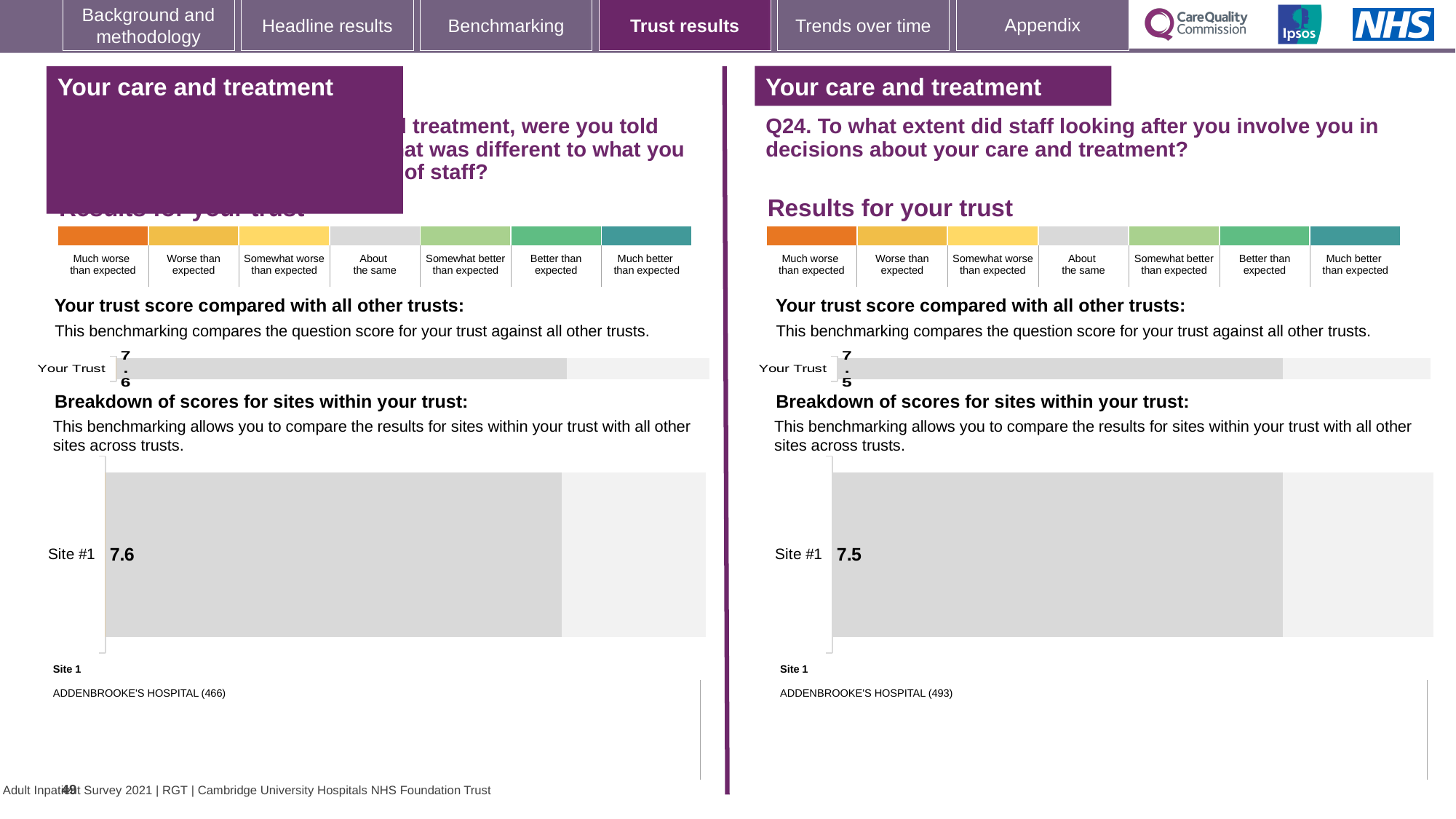
On the right-hand Q24 'Your trust score compared with all other trusts' chart, what is the score for Your Trust? 7.5 What kind of chart is used for the 'Your Trust' score on the right-hand Q24 section? Bar chart Which is larger: the Your Trust score on the left-hand chart or the Your Trust score on the right-hand Q24 chart? The left-hand chart (7.6) How many sites are shown in the right-hand Q24 'Breakdown of scores for sites within your trust' chart? 1 How many sites are shown in the left-hand 'Breakdown of scores for sites within your trust' chart? 1 On the left-hand 'Breakdown of scores for sites within your trust' chart, what is the score for Site #1? 7.6 On the left-hand 'Your trust score compared with all other trusts' chart, what is the score for Your Trust? 7.6 On the right-hand Q24 section, which hospital is listed as Site 1? ADDENBROOKE'S HOSPITAL (493) How many categories are shown in the colour scale key above the left-hand 'Your trust score' chart, from 'Much worse than expected' to 'Much better than expected'? 7 On the right-hand Q24 'Breakdown of scores for sites within your trust' chart, what is the score for Site #1? 7.5 What is the difference between the Site #1 score on the left-hand breakdown chart and the Site #1 score on the right-hand Q24 breakdown chart? 0.1